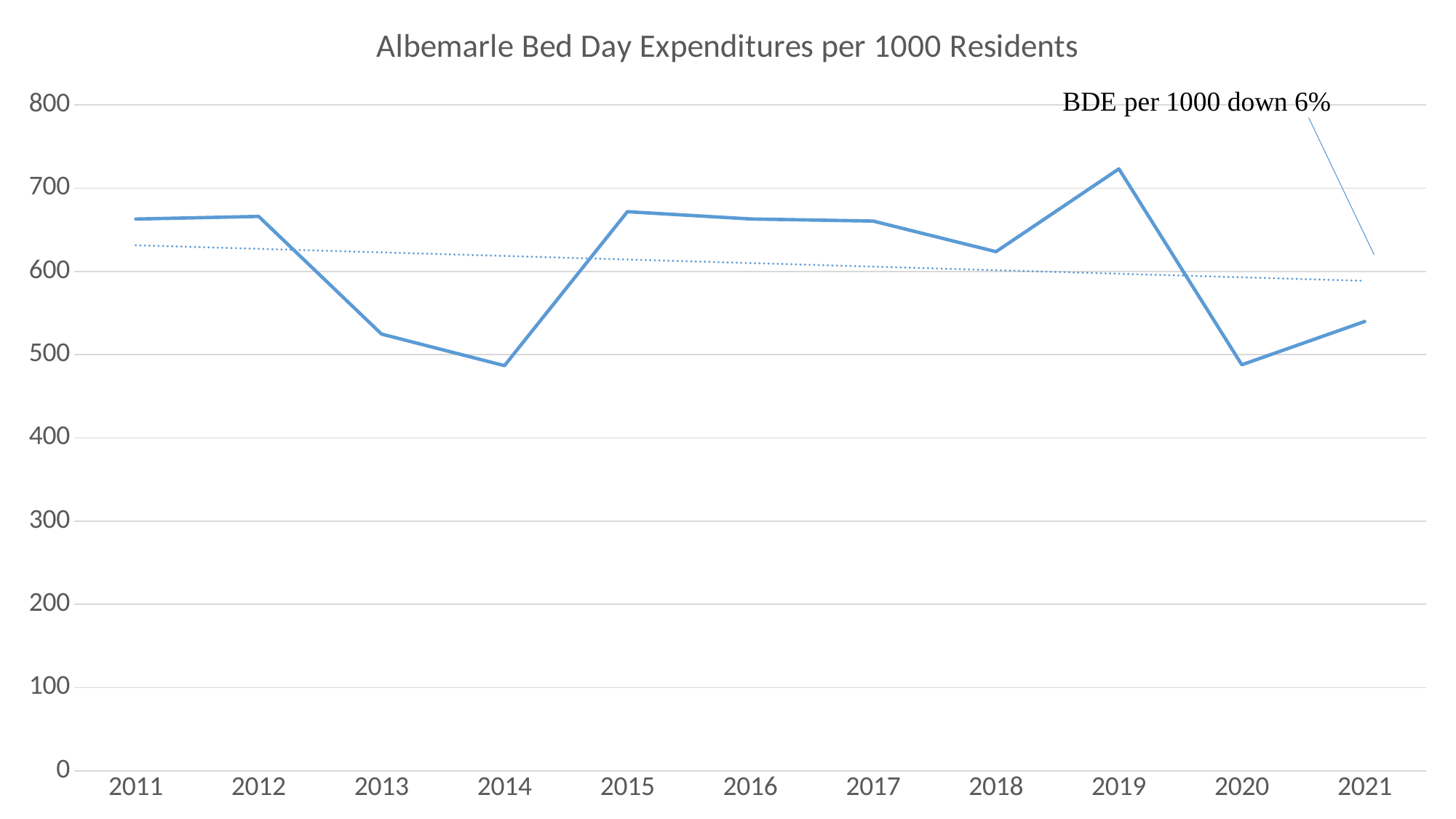
Is the value for 2019 greater or less than 700? greater Which is larger, the value for 2019 or the value for 2020? 2019 Is the value for 2018 greater or less than 600? greater Is the value for 2014 greater or less than 500? less What does the text annotation on the chart say? BDE per 1000 down 6% What kind of chart is shown on the slide? line chart Which year has the highest value? 2019 How many years are plotted along the x axis? 11 Which is larger, the value for 2013 or the value for 2015? 2015 Does the value rise or fall from 2019 to 2020? fall What is the title of the chart? Albemarle Bed Day Expenditures per 1000 Residents